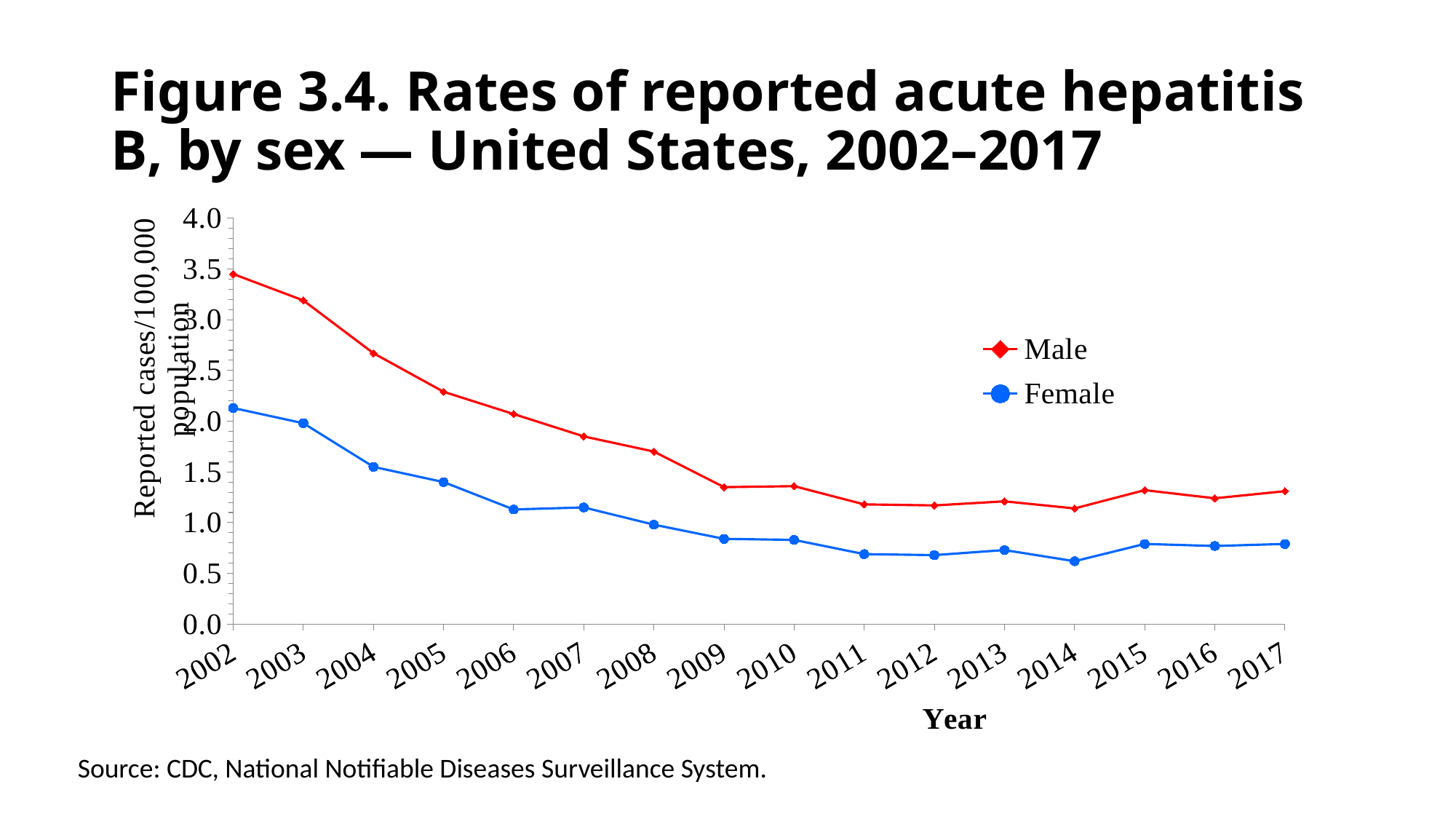
Is the Male value for 2002 greater or less than 3.0? greater In which year is the Male rate highest? 2002 Is the Female value for 2004 greater or less than 2.0? less In 2002, which series has the higher rate, Male or Female? Male How many years are plotted along the x axis? 16 In which year is the Female rate lowest? 2014 How many series does the legend list? 2 What colour is the Female line? blue What kind of chart is shown on the slide? line chart Is the Female value for 2011 greater or less than 1.0? less Does the Male rate rise or fall from 2002 to 2009? fall